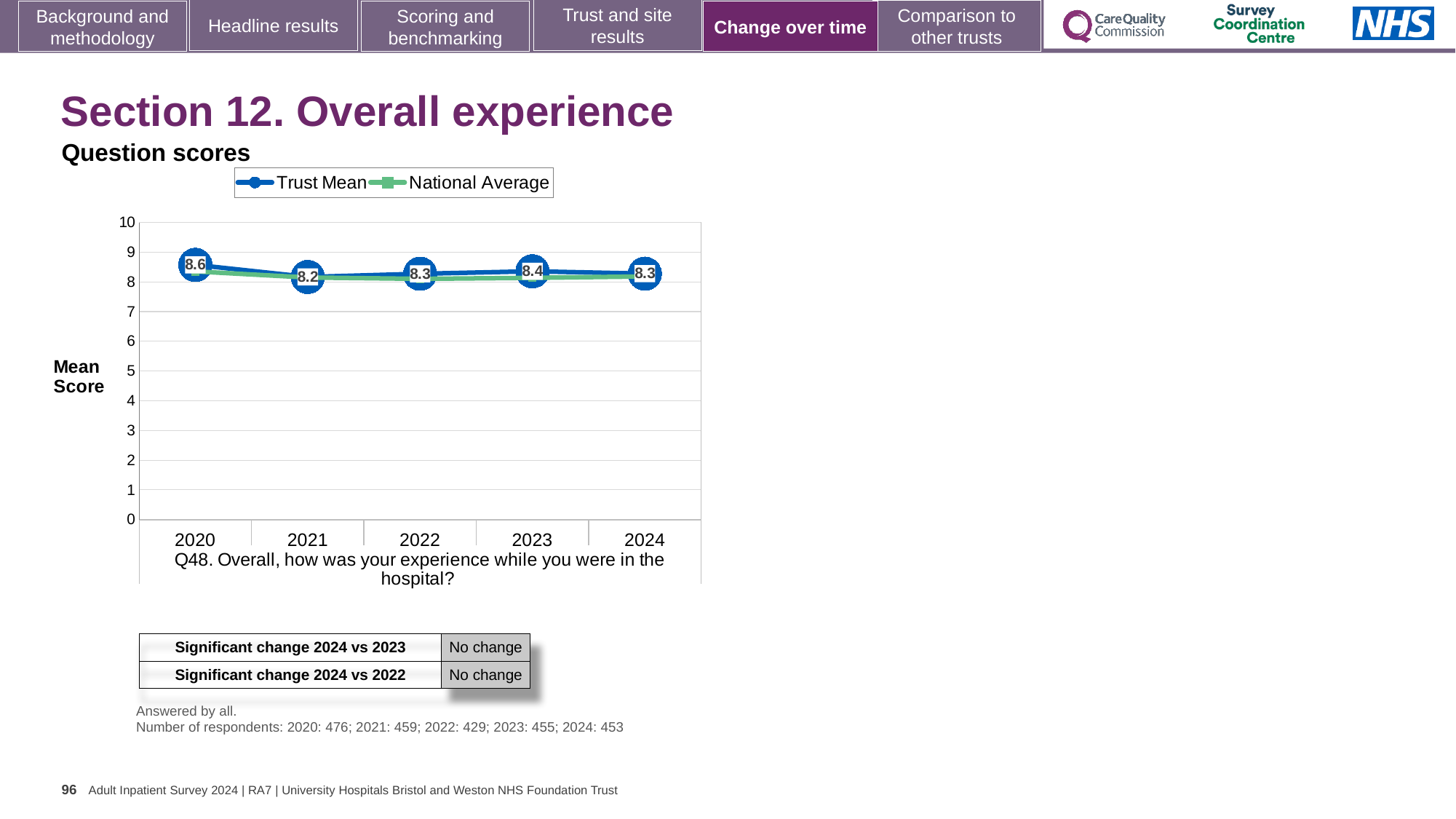
How many years are plotted on the x axis? 5 Which year has the larger Trust Mean, 2023 or 2021? 2023 What is the Trust Mean score for 2024? 8.3 What is the Trust Mean score for 2021? 8.2 What is the difference between the Trust Mean in 2020 and in 2021? 0.4 In which year is the Trust Mean highest? 2020 Is the National Average value for 2022 greater or less than 5? greater Does the Trust Mean rise or fall from 2020 to 2021? Fall What is the Trust Mean score for 2020? 8.6 How many series does the legend list? 2 In which year is the Trust Mean lowest? 2021 What kind of chart is shown on the slide? Line chart